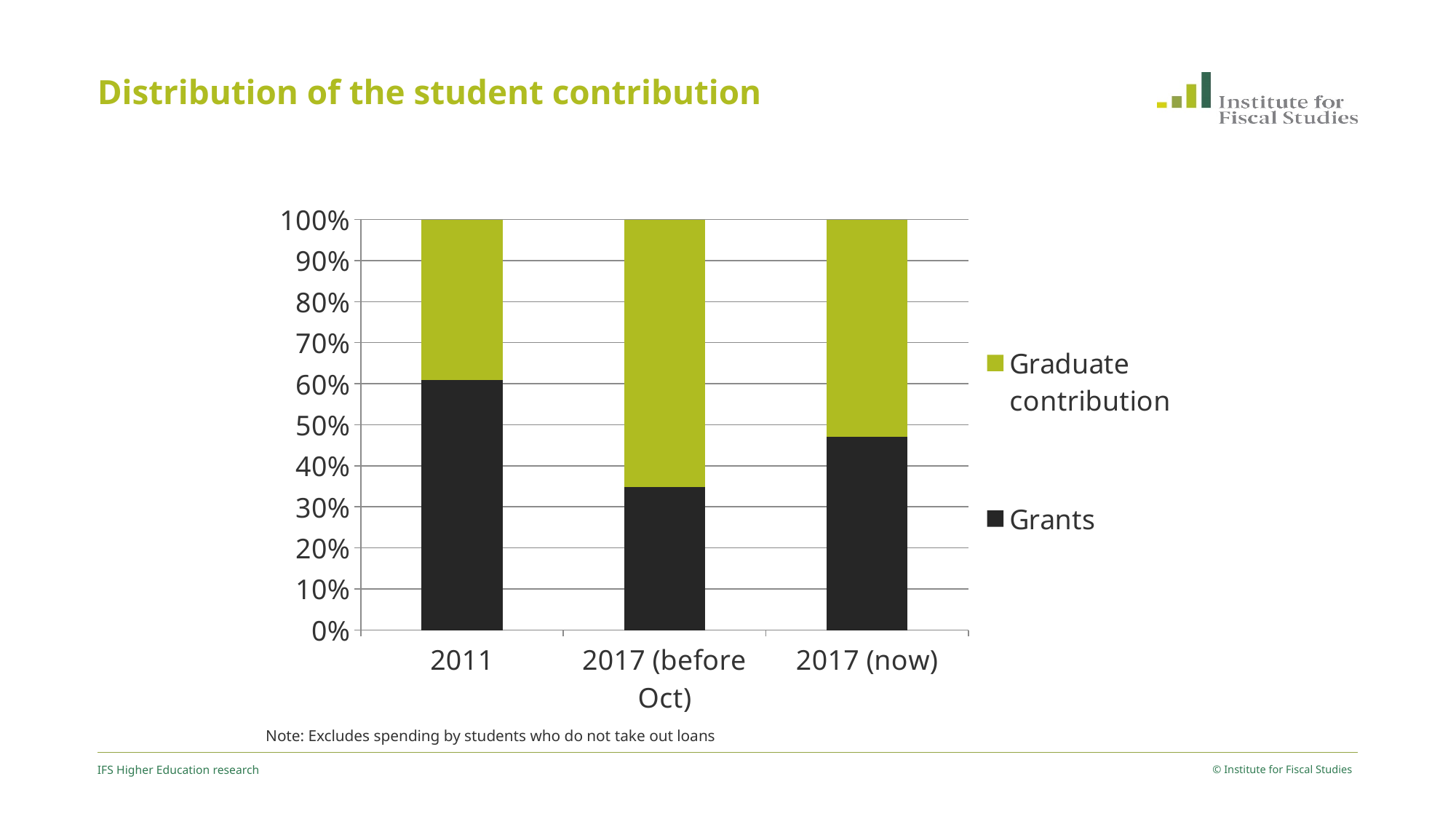
Is the Grants share for 2017 (before Oct) greater or less than 40%? less What is the title of the chart? Distribution of the student contribution What kind of chart is shown on the slide? stacked bar chart Which category has the highest Graduate contribution share? 2017 (before Oct) Which category has the lowest Grants share? 2017 (before Oct) Which is larger, the Grants share for 2011 or for 2017 (now)? 2011 How many categories are shown on the x axis? 3 Which series is shown in green? Graduate contribution Is the Grants share for 2017 (now) greater or less than 40%? greater How many series does the legend list? 2 Which category has the highest Grants share? 2011 Is the Grants share for 2011 greater or less than 50%? greater